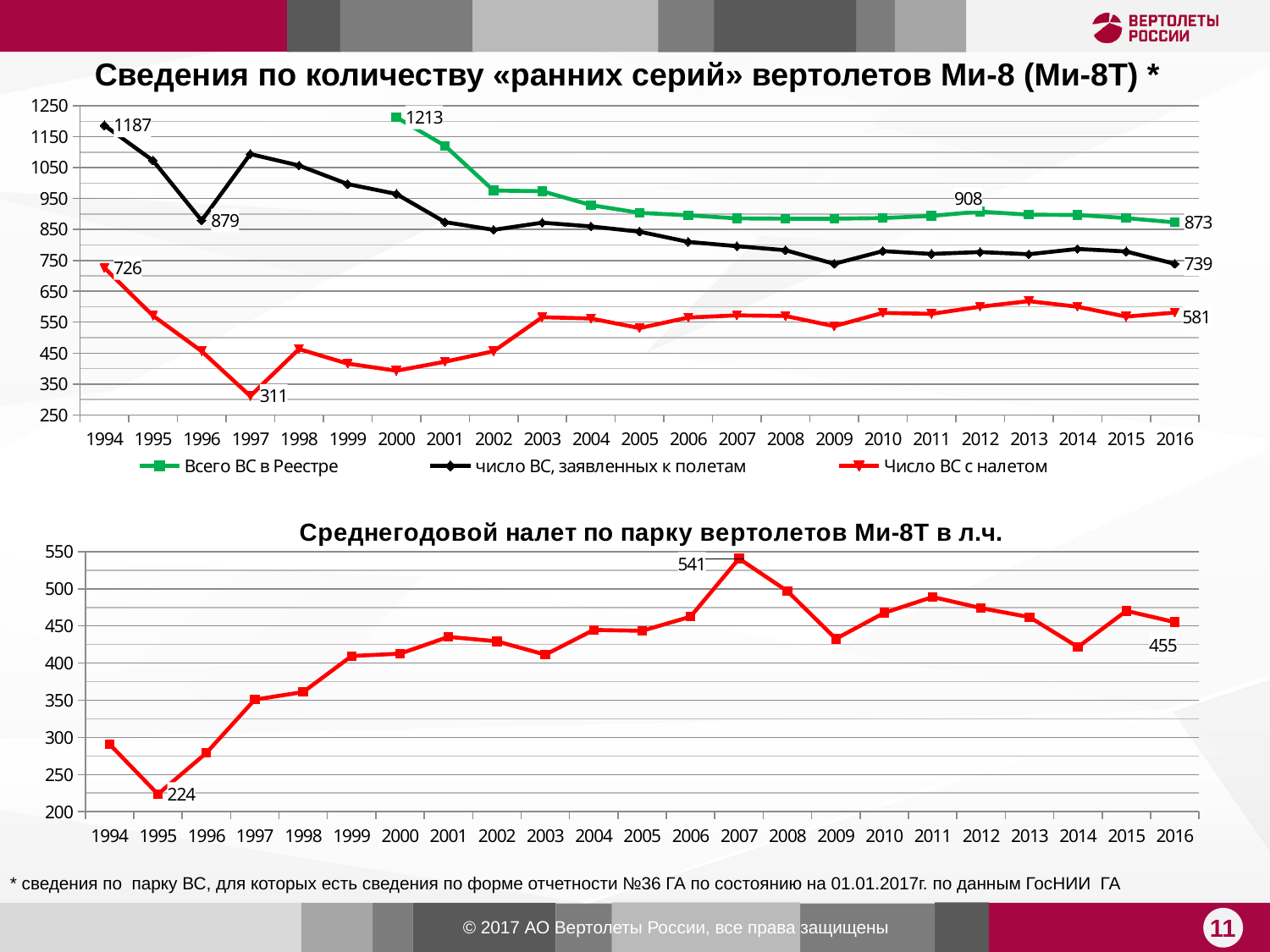
In the top chart, what is the value of «Всего ВС в Реестре» in 2016? 873 In the top chart, what is the difference between «Всего ВС в Реестре» and «число ВС, заявленных к полетам» in 2016? 134 In the top chart, what is the value of «Число ВС с налетом» in 1997? 311 In the top chart, what is the value of «число ВС, заявленных к полетам» in 1994? 1187 What kind of chart is the bottom chart «Среднегодовой налет по парку вертолетов Ми-8Т в л.ч.»? line chart In the top chart, how many series does the legend list? 3 In the top chart, which series has the lowest value in 2016? Число ВС с налетом In the bottom chart «Среднегодовой налет по парку вертолетов Ми-8Т в л.ч.», which year has the lowest value? 1995 In the bottom chart «Среднегодовой налет по парку вертолетов Ми-8Т в л.ч.», what is the difference between the 2007 value and the 2016 value? 86 In the top chart, is the value of «Число ВС с налетом» in 2005 greater or less than 550? less In the bottom chart «Среднегодовой налет по парку вертолетов Ми-8Т в л.ч.», what is the value in 2007? 541 In the top chart, what is the value of «Всего ВС в Реестре» in 2000? 1213